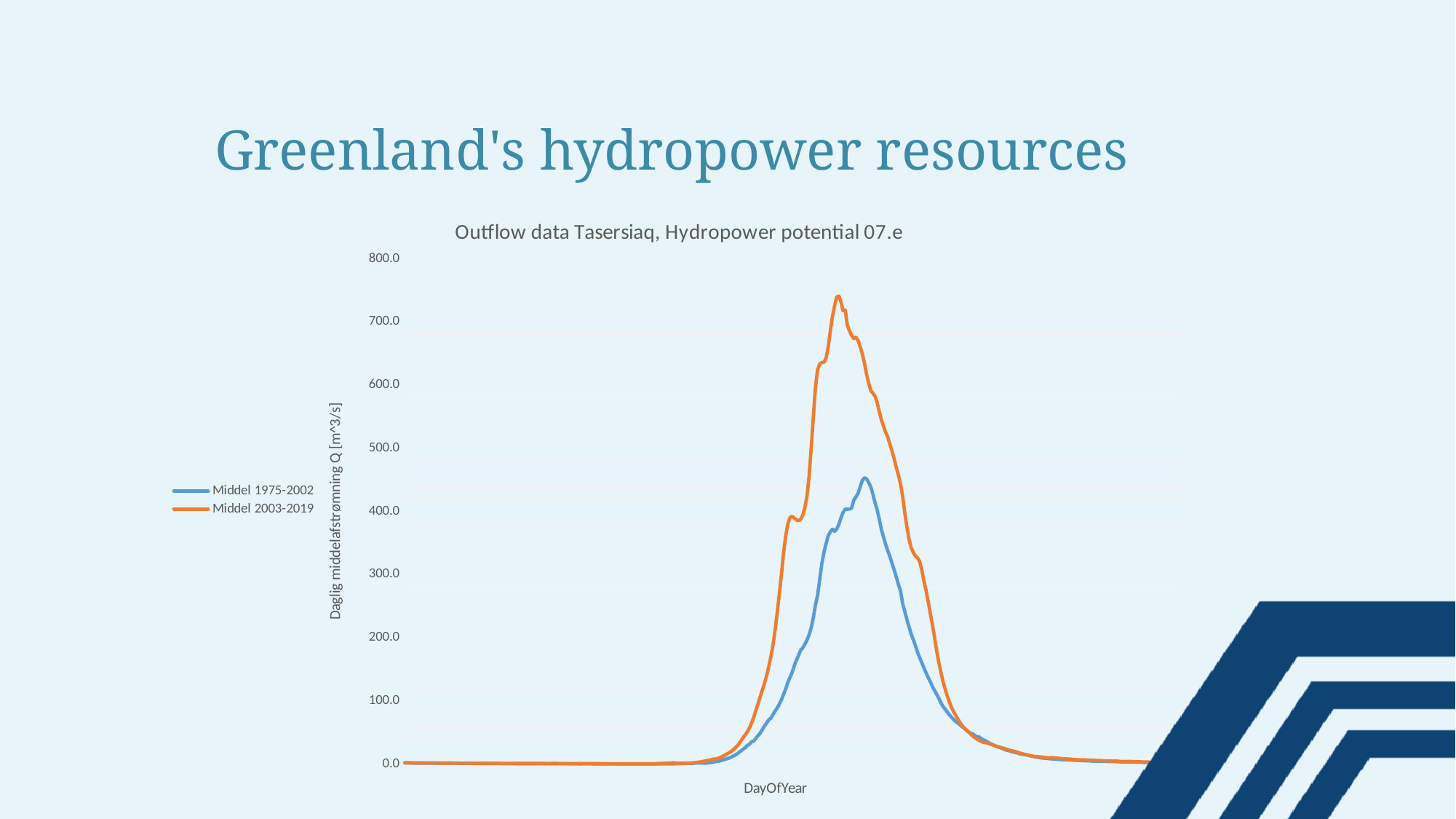
How many series does the legend list? 2 What kind of chart is shown on the slide? line chart What is the highest value shown on the y axis? 800.0 What is the label of the x axis? DayOfYear Is the peak value of the Middel 2003-2019 series greater or less than 700.0? greater Is the peak value of the Middel 2003-2019 series greater or less than 800.0? less Which series reaches the higher peak value, Middel 1975-2002 or Middel 2003-2019? Middel 2003-2019 Is the peak value of the Middel 1975-2002 series greater or less than 500.0? less Which series has the lower peak value? Middel 1975-2002 What is the title of the chart? Outflow data Tasersiaq, Hydropower potential 07.e